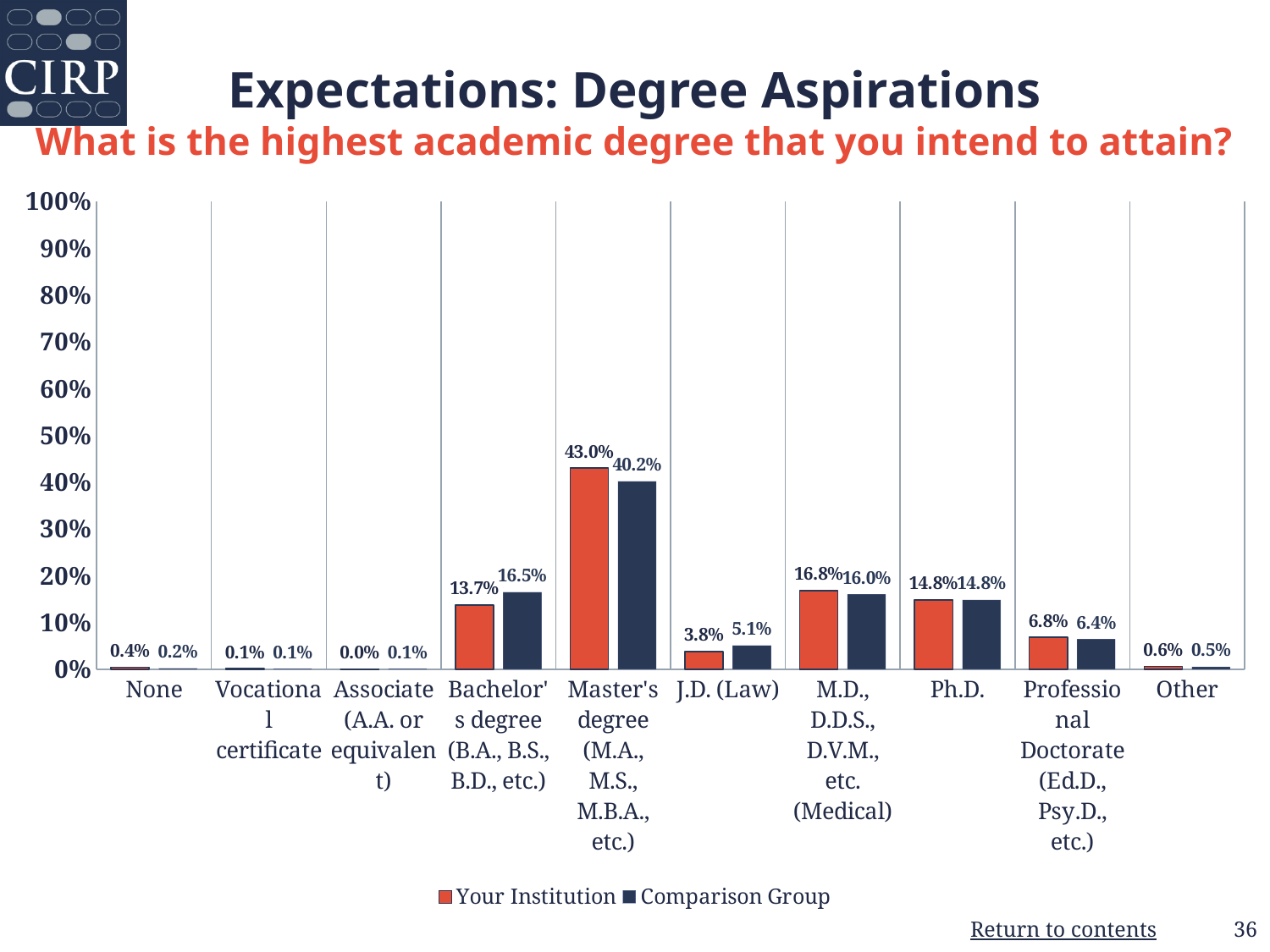
Which category has the highest value for Your Institution? Master's degree What is the value for Comparison Group for Bachelor's degree? 16.5% Which category has the lowest value for Your Institution? Associate (A.A. or equivalent) What kind of chart is shown on the slide? bar chart What colour are the Your Institution bars? orange-red How many series does the legend list? 2 How many categories are shown on the x axis? 10 What is the value for Your Institution for J.D. (Law)? 3.8% What is the value for Your Institution for Master's degree? 43.0% What is the difference between Your Institution and Comparison Group for Master's degree? 2.8% Which is larger for Bachelor's degree: Your Institution or Comparison Group? Comparison Group Is the value for Your Institution for Master's degree greater or less than 40%? greater